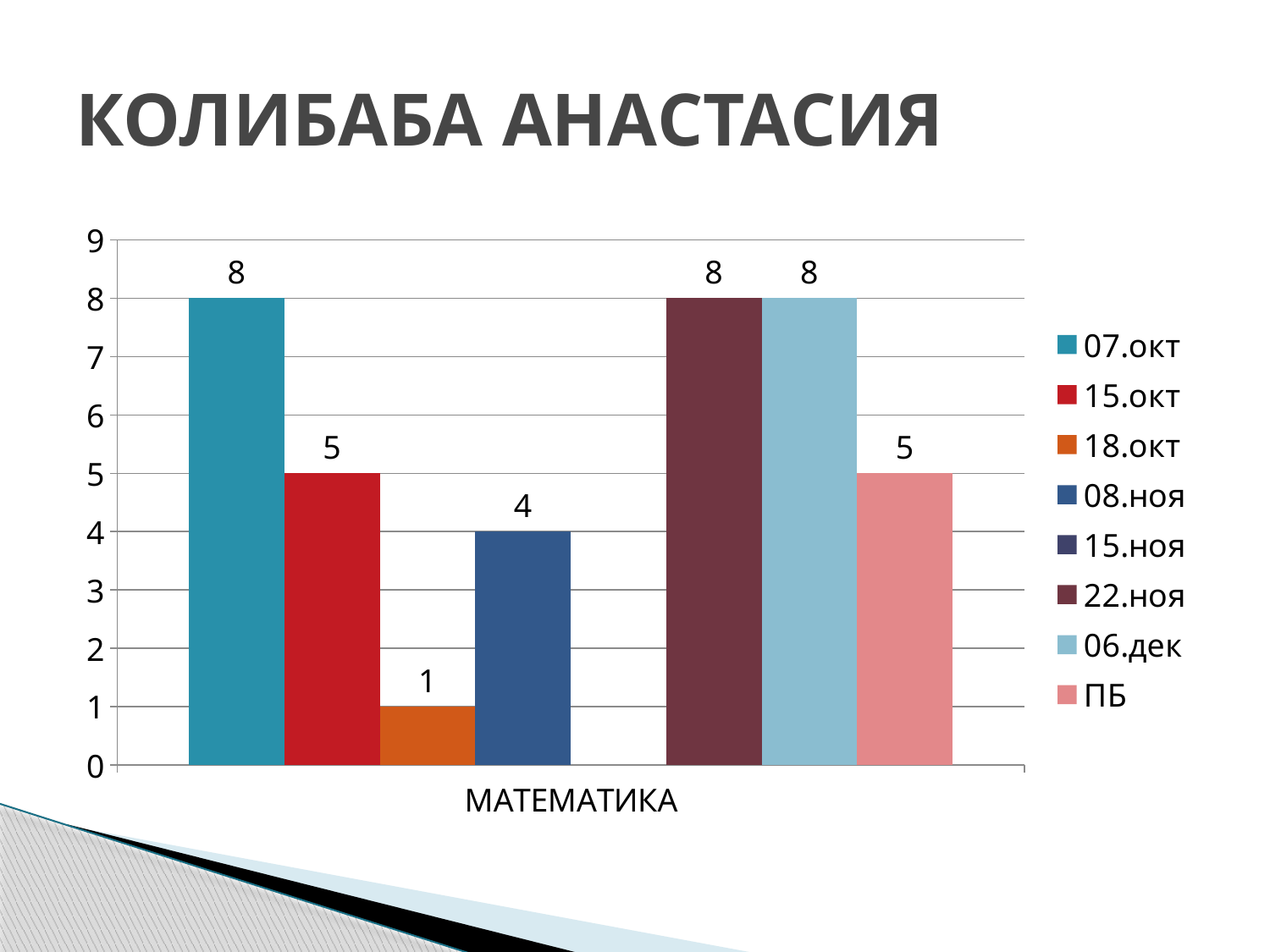
What is the difference between the values for 07.окт and 15.окт? 3 How many series does the legend list? 8 What is the value for ПБ? 5 Which series has the lowest value? 18.окт What is the value for 15.окт? 5 What kind of chart is shown on the slide? bar chart What is the value for 18.окт? 1 What is the category label shown on the x axis? МАТЕМАТИКА What is the difference between the values for 08.ноя and 18.окт? 3 What is the value for 07.окт in the МАТЕМАТИКА category? 8 Which is larger, the value for 22.ноя or the value for ПБ? 22.ноя What is the value for 08.ноя? 4